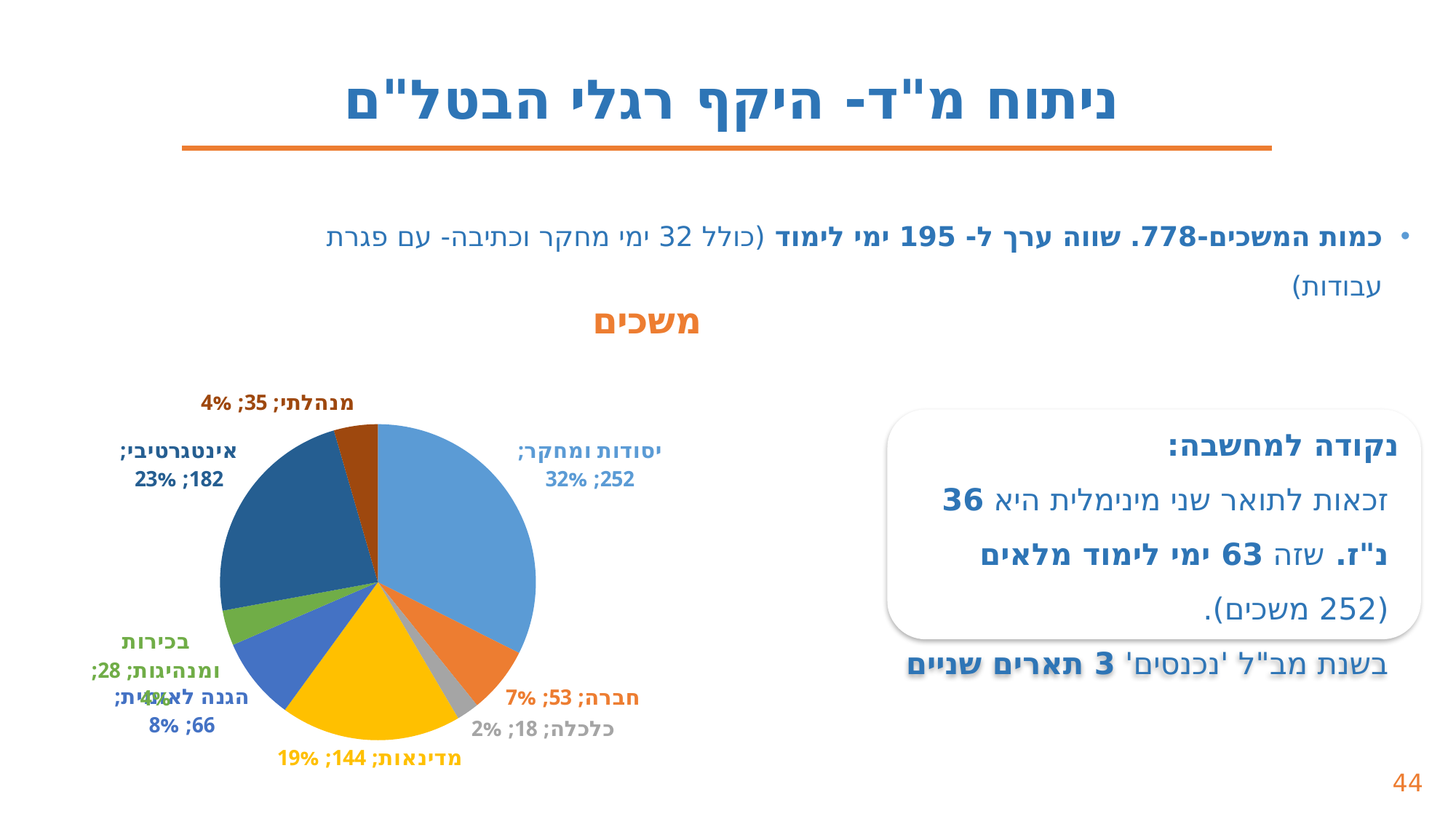
What is the value for "מדינאות" in the pie chart? 144 How many categories are shown in the pie chart? 8 What is the title of the pie chart? משכים Which category has the largest slice in the pie chart? יסודות ומחקר What percentage share does "אינטגרטיבי" have in the pie chart? 23% What is the difference between the values for "אינטגרטיבי" and "מדינאות" in the pie chart? 38 What is the value for "יסודות ומחקר" in the pie chart? 252 What kind of chart is shown under the title "משכים"? pie chart What percentage share does "כלכלה" have in the pie chart? 2% Which is larger in the pie chart: "חברה" or "הגנה לאומית"? הגנה לאומית What is the value for "מנהלתי" in the pie chart? 35 Which category has the smallest slice in the pie chart? כלכלה